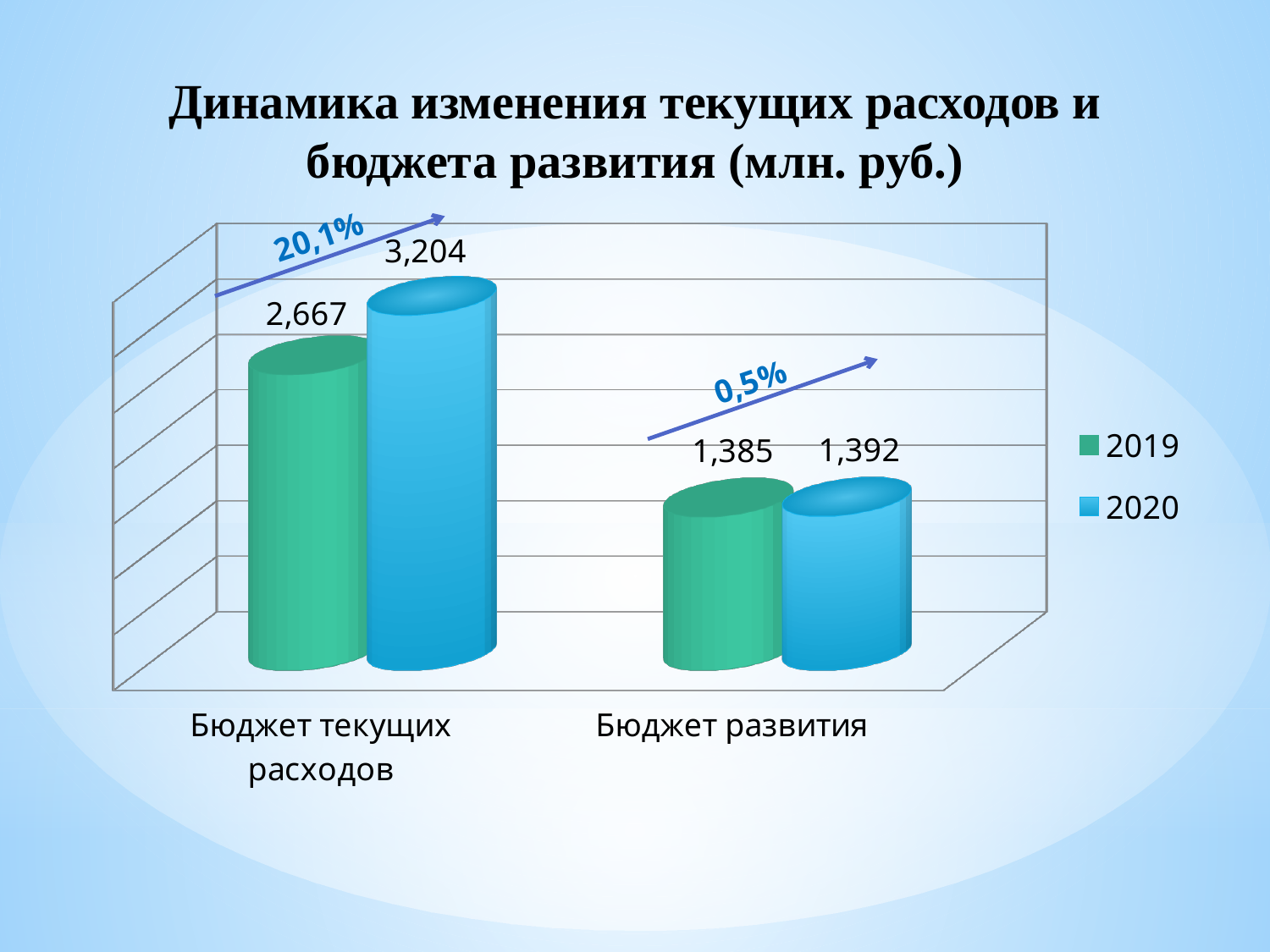
What is the value for 2019 in the 'Бюджет развития' category? 1,385 How many categories are shown on the x axis? 2 What is the difference between the 2020 and 2019 values for 'Бюджет развития'? 7 How many series does the legend list? 2 What is the value for 2020 in the 'Бюджет текущих расходов' category? 3,204 For 'Бюджет текущих расходов', which year has the larger value, 2019 or 2020? 2020 What is the value for 2019 in the 'Бюджет текущих расходов' category? 2,667 What is the difference between the 2020 and 2019 values for 'Бюджет текущих расходов'? 537 Which bar has the highest value on the chart? 2020, Бюджет текущих расходов Which bar has the lowest value on the chart? 2019, Бюджет развития What kind of chart is shown on the slide? Bar chart What is the value for 2020 in the 'Бюджет развития' category? 1,392